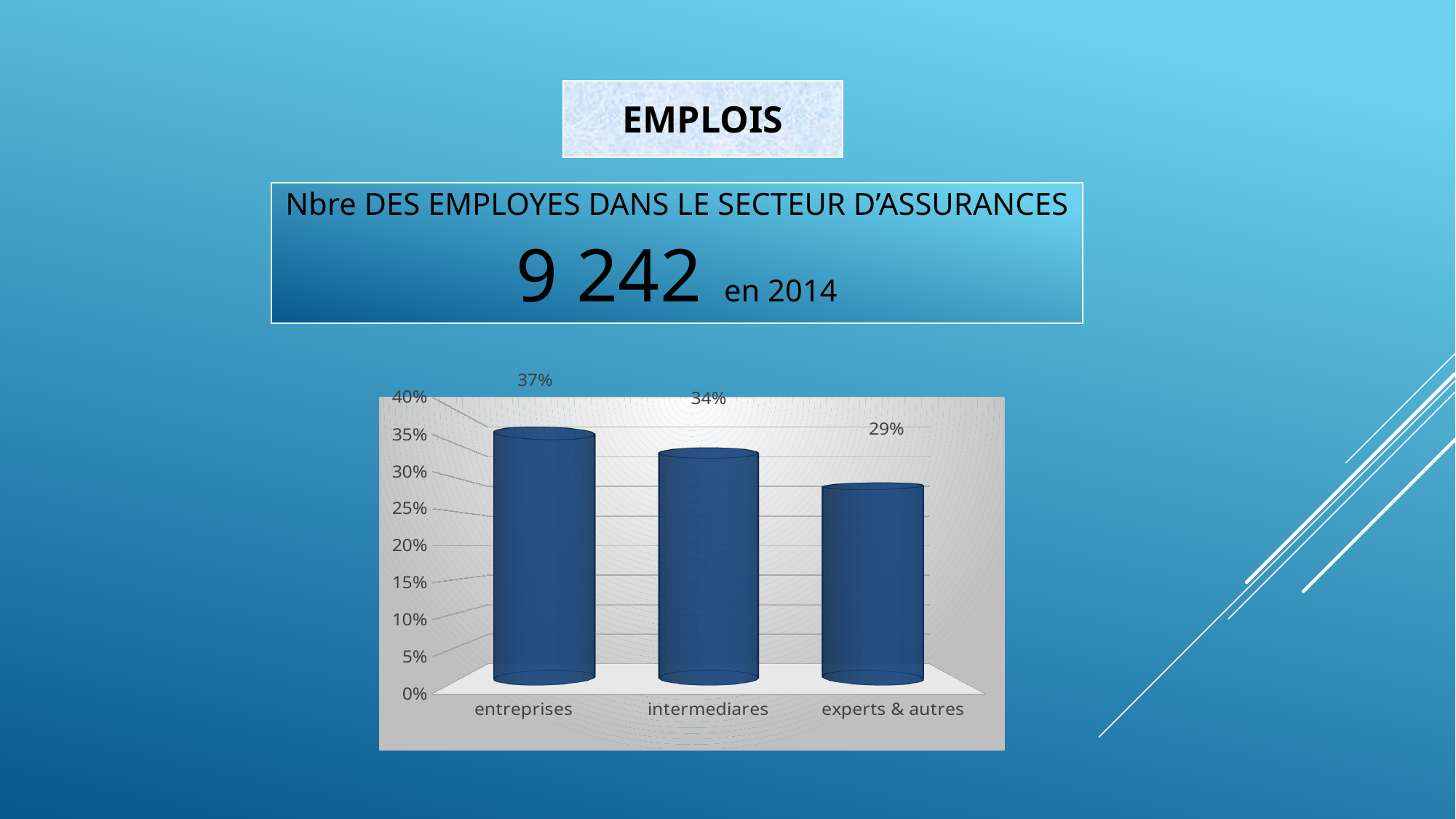
What is the value for intermediares? 34% What is the value for experts & autres? 29% Do the values rise or fall from left to right along the x axis? fall What is the difference between the values for entreprises and intermediares? 3% Which category has the lowest value? experts & autres What is the difference between the values for entreprises and experts & autres? 8% Which category has the highest value? entreprises Which is larger, the value for intermediares or the value for experts & autres? intermediares Is the value for experts & autres greater or less than 30%? less What is the value for entreprises? 37% What kind of chart is shown on the slide? bar chart How many categories are shown on the x axis? 3